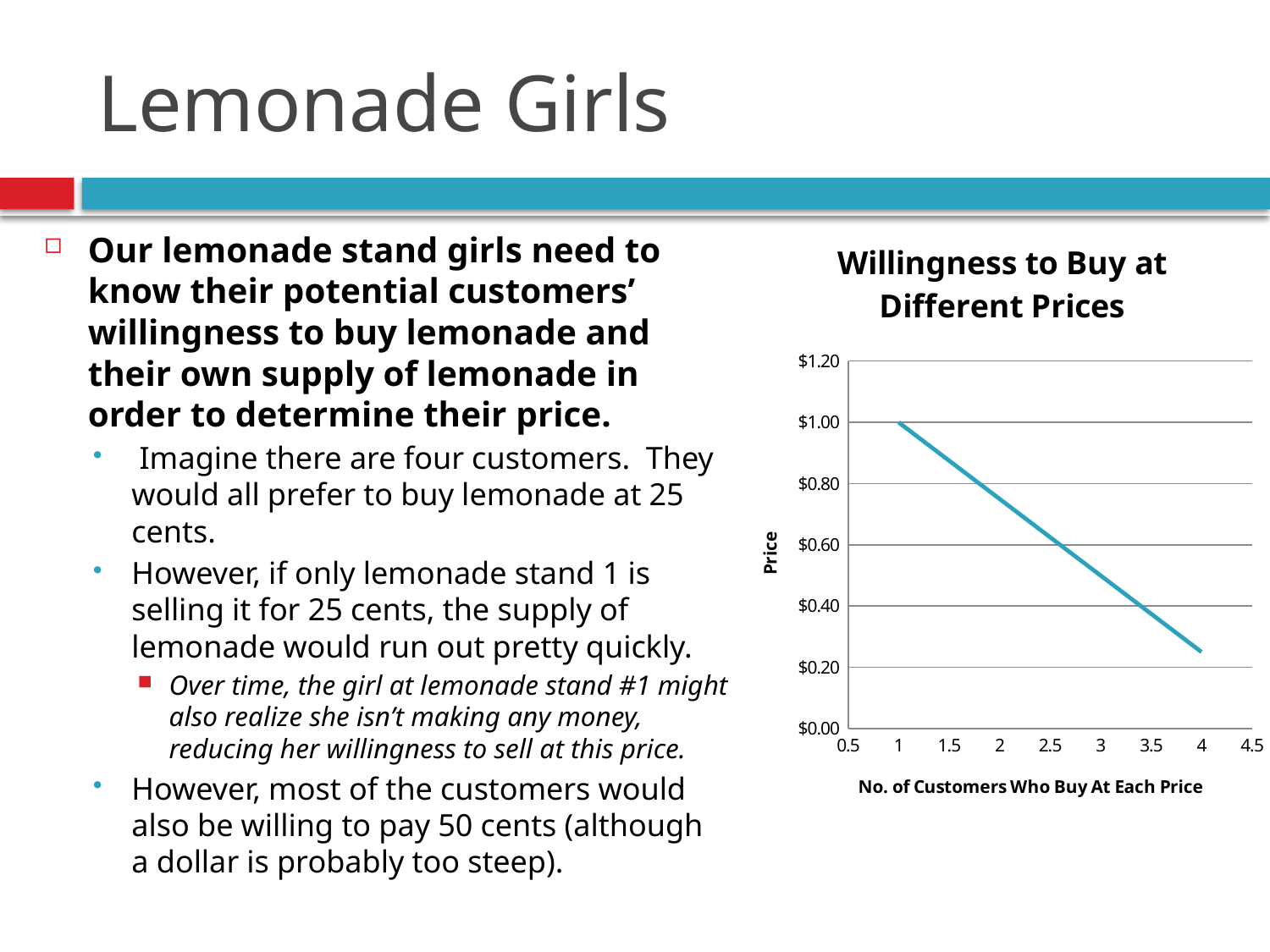
Is the price at 3 customers greater or less than $0.60? less What is the label of the horizontal axis of the chart? No. of Customers Who Buy At Each Price What is the price when 1 customer buys? $1.00 What kind of chart is shown on the slide? line chart Which has the higher price, 1 customer or 4 customers? 1 customer Is the price at 4 customers greater or less than $0.20? greater Is the price at 2 customers greater or less than $0.60? greater Does the price rise or fall as the number of customers increases along the x axis? fall What is the title of the chart? Willingness to Buy at Different Prices At which number of customers is the price highest? 1